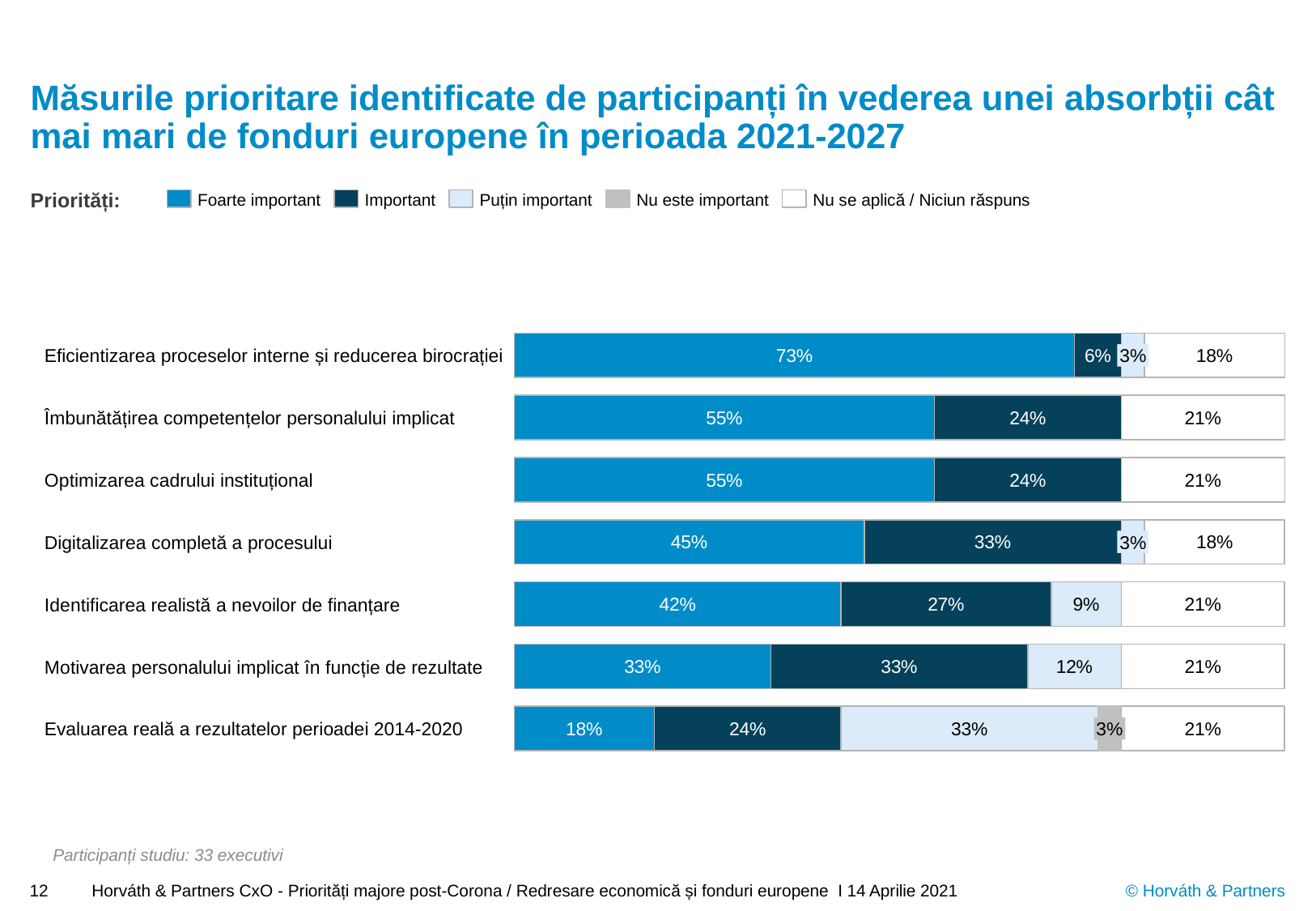
How many series does the legend list? 5 Which measure has the lowest 'Foarte important' share? Evaluarea reală a rezultatelor perioadei 2014-2020 Which legend entry is shown in the light grey colour? Nu este important What is the 'Important' value for 'Digitalizarea completă a procesului'? 33% Which measure has the highest 'Foarte important' share? Eficientizarea proceselor interne și reducerea birocrației How many priority measures (categories) are plotted in the chart? 7 What is the combined 'Foarte important' and 'Important' share for 'Motivarea personalului implicat în funcție de rezultate'? 66% Which is larger: the 'Important' value for 'Identificarea realistă a nevoilor de finanțare' or for 'Îmbunătățirea competențelor personalului implicat'? Identificarea realistă a nevoilor de finanțare What is the 'Foarte important' value for 'Eficientizarea proceselor interne și reducerea birocrației'? 73% What is the 'Puțin important' value for 'Evaluarea reală a rezultatelor perioadei 2014-2020'? 33% What is the difference between the 'Foarte important' values for 'Eficientizarea proceselor interne și reducerea birocrației' and 'Optimizarea cadrului instituțional'? 18% What kind of chart is shown on the slide? Stacked bar chart